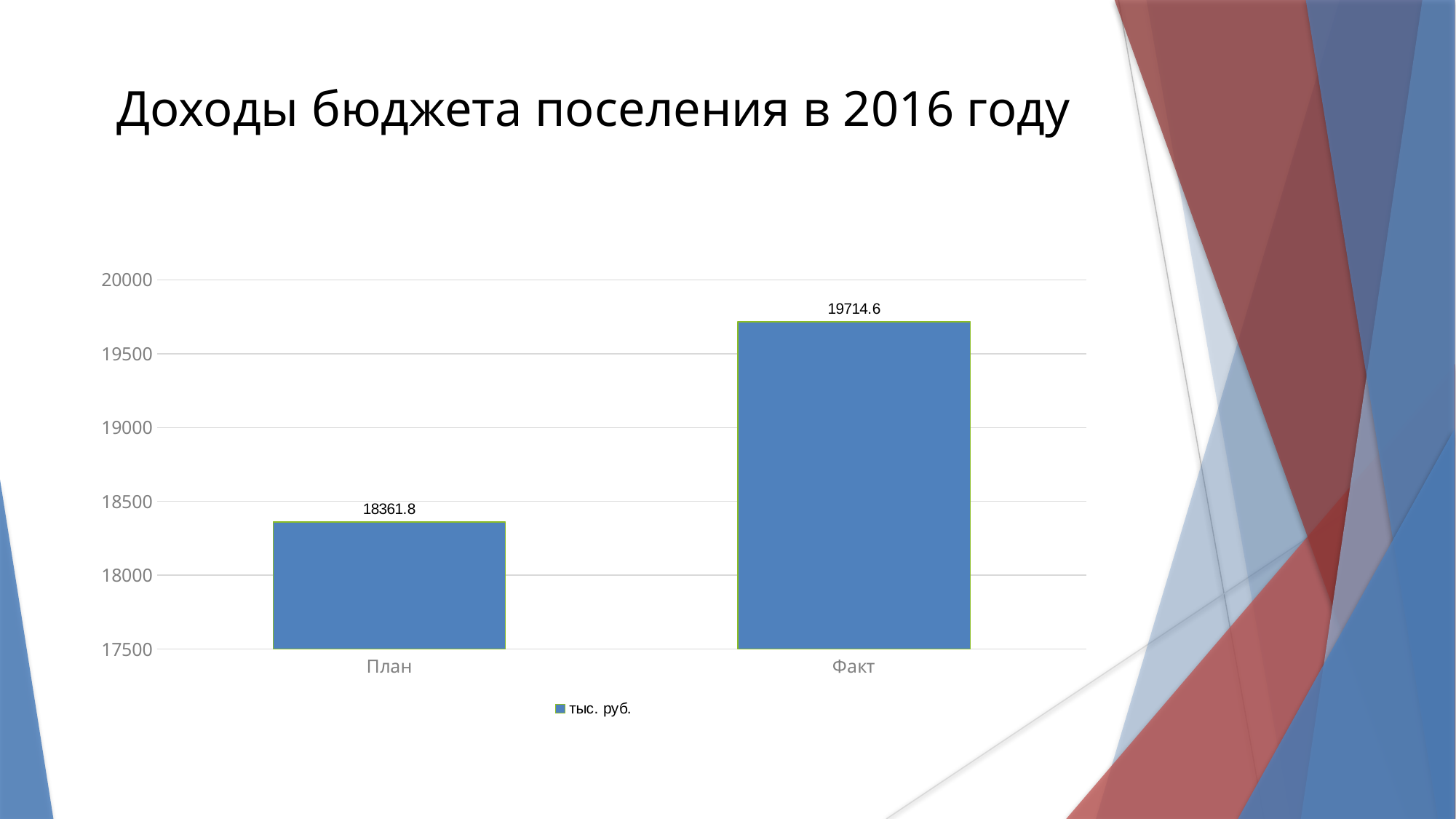
How many series does the legend list? 1 Is the value for Факт greater or less than 19500? greater Which category has the lowest value? План Is the value for План greater or less than 18500? less What is the difference between the values for Факт and План? 1352.8 How many categories are shown on the chart? 2 What is the legend entry of the chart? тыс. руб. What is the value for Факт? 19714.6 What is the value for План? 18361.8 What kind of chart is shown on the slide? bar chart Which is larger, the value for План or the value for Факт? Факт Which category has the highest value? Факт